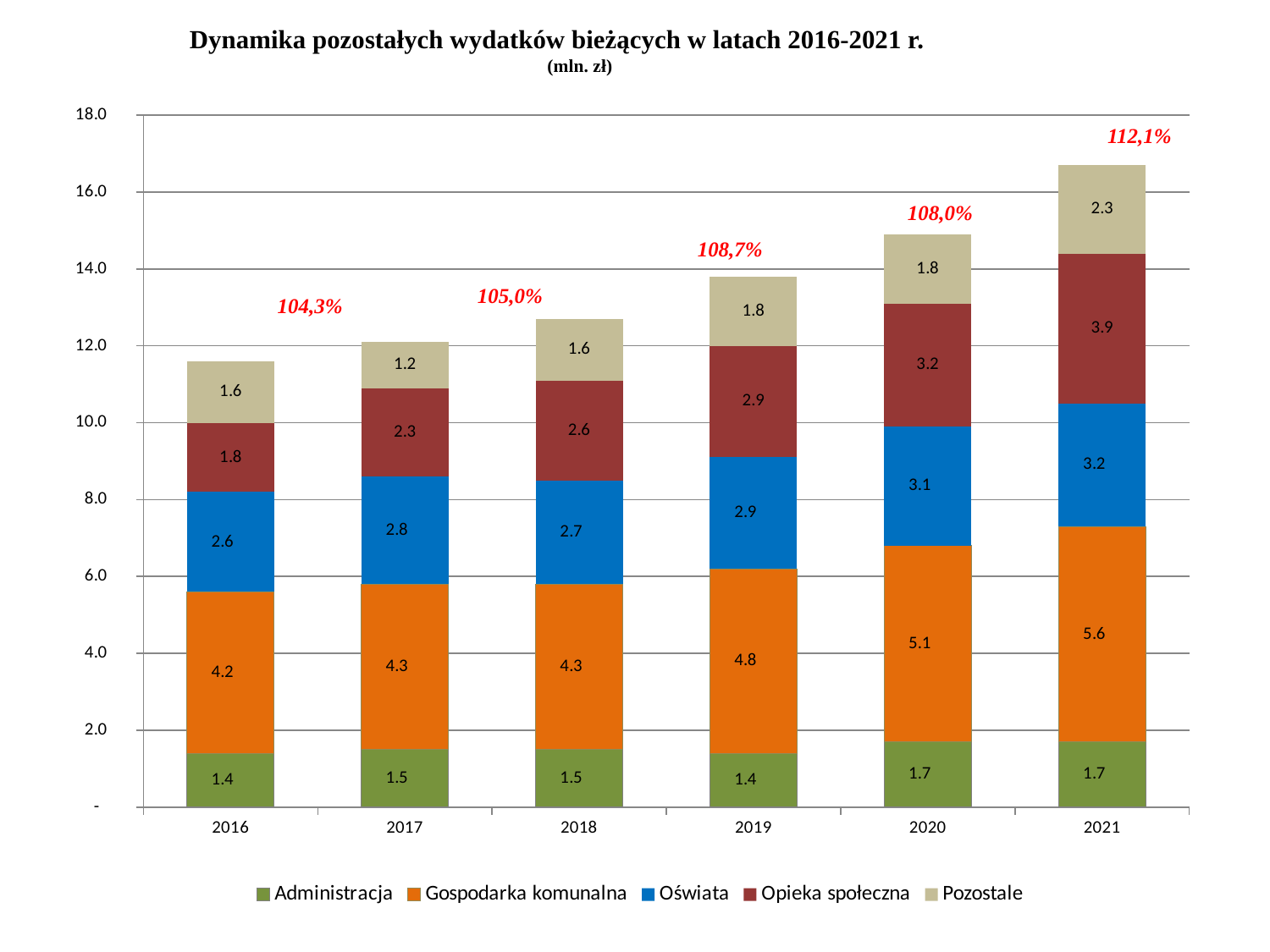
What is the total of the stacked bar for 2021? 16.7 What is the value for Opieka społeczna in 2018? 2.6 What type of chart is shown on the slide? stacked bar chart Which is larger in 2020: Oświata or Opieka społeczna? Opieka społeczna How many series does the legend list? 5 In which year is the value for Pozostale the lowest? 2017 What is the value for Pozostale in 2017? 1.2 What is the difference between the Gospodarka komunalna values in 2021 and 2016? 1.4 What is the value for Gospodarka komunalna in 2021? 5.6 In which year is the value for Oświata the highest? 2021 How many years are shown on the x axis? 6 What percentage label is shown above the 2019 bar? 108,7%